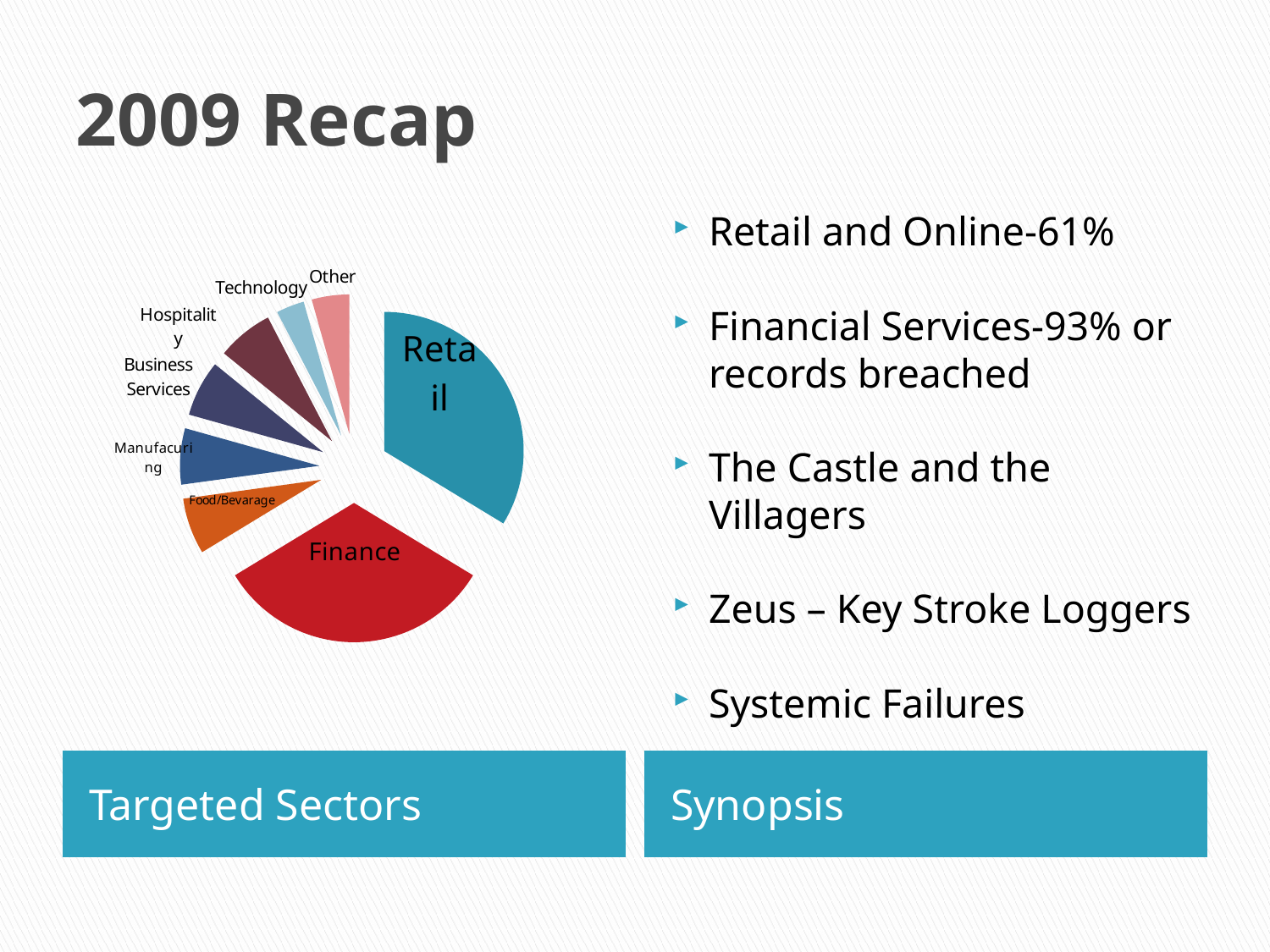
Which slice is larger in the pie chart, Finance or Manufacturing? Finance What kind of chart is shown on the slide? pie chart Which slice is larger in the pie chart, Retail or Technology? Retail How many sectors (slices) does the pie chart show? 8 Which slice is larger in the pie chart, Retail or Food/Bevarage? Retail What colour is the Finance slice in the pie chart? red What is the caption under the pie chart? Targeted Sectors